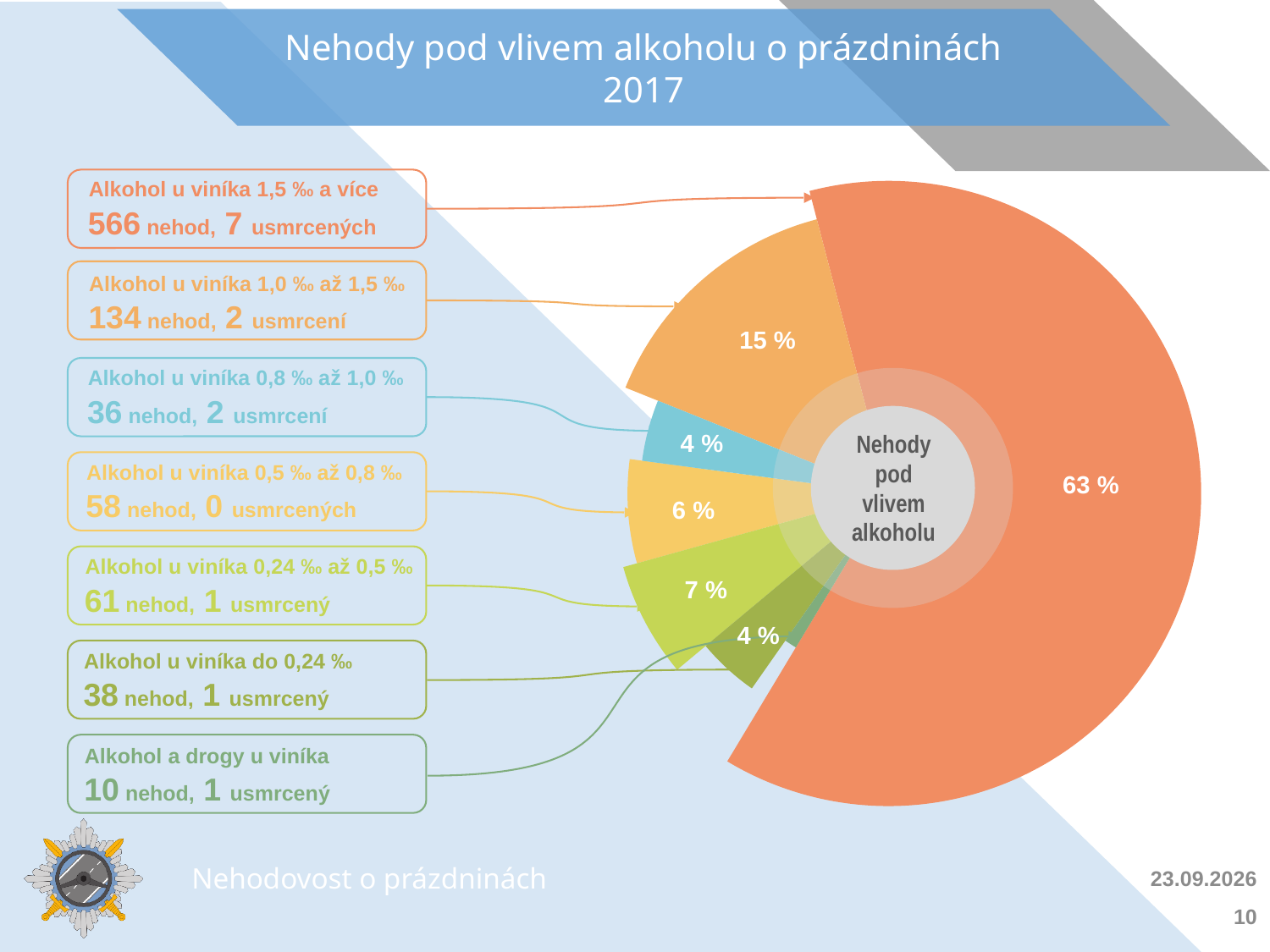
What text is written in the centre of the pie chart? Nehody pod vlivem alkoholu What is the title of the slide containing the chart? Nehody pod vlivem alkoholu o prázdninách 2017 How many accidents (nehod) are listed for 'Alkohol u viníka 0,5 ‰ až 0,8 ‰'? 58 What share of the pie is labelled for the slice linked to 'Alkohol u viníka 1,0 ‰ až 1,5 ‰'? 15 % What kind of chart is shown on the slide? pie chart How many accidents (nehod) are listed for 'Alkohol u viníka 1,5 ‰ a více'? 566 Which category has the fewest accidents (nehod)? Alkohol a drogy u viníka Which has more accidents: 'Alkohol u viníka 0,24 ‰ až 0,5 ‰' or 'Alkohol u viníka do 0,24 ‰'? Alkohol u viníka 0,24 ‰ až 0,5 ‰ What share of the pie does the largest slice (Alkohol u viníka 1,5 ‰ a více) represent? 63 % What is the difference in the number of accidents between 'Alkohol u viníka 1,5 ‰ a více' and 'Alkohol u viníka 1,0 ‰ až 1,5 ‰'? 432 How many people killed (usmrcených) are listed for 'Alkohol u viníka 1,5 ‰ a více'? 7 Which category has the most accidents (nehod)? Alkohol u viníka 1,5 ‰ a více